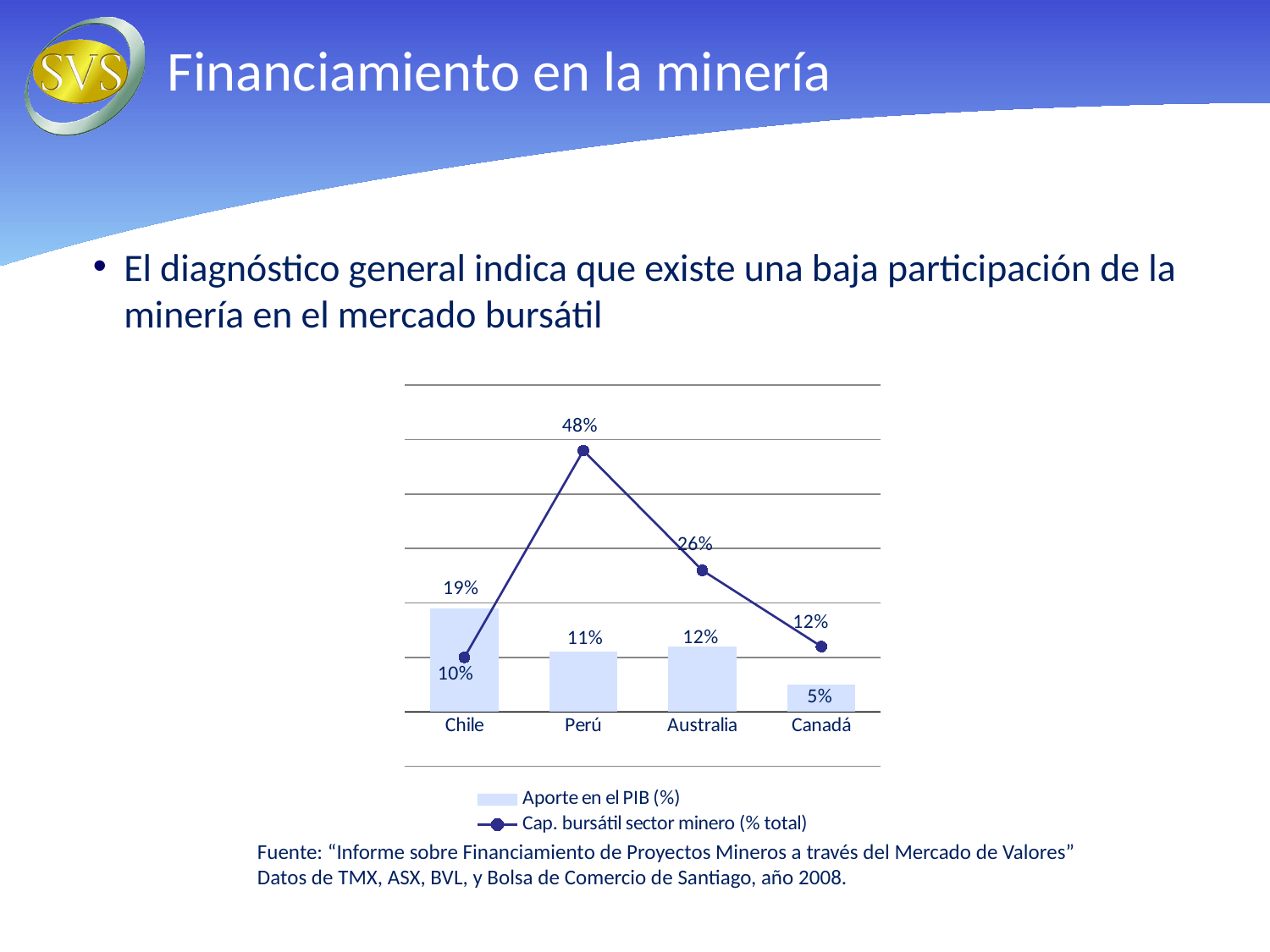
What is the value of Aporte en el PIB (%) for Chile? 19% What kind of chart is shown on the slide? Combined bar and line chart How many series does the chart legend list? 2 What is the value of Aporte en el PIB (%) for Canadá? 5% Which is larger for Chile: Aporte en el PIB (%) or Cap. bursátil sector minero (% total)? Aporte en el PIB (%) Which country has the highest Cap. bursátil sector minero (% total)? Perú Which country has the lowest Aporte en el PIB (%)? Canadá Does the Cap. bursátil sector minero (% total) line rise or fall from Perú to Canadá? Fall What is the difference between the Cap. bursátil sector minero (% total) for Perú and for Chile? 38% What is the value of Cap. bursátil sector minero (% total) for Australia? 26% What is the value of Cap. bursátil sector minero (% total) for Perú? 48% How many countries are shown on the x axis of the chart? 4